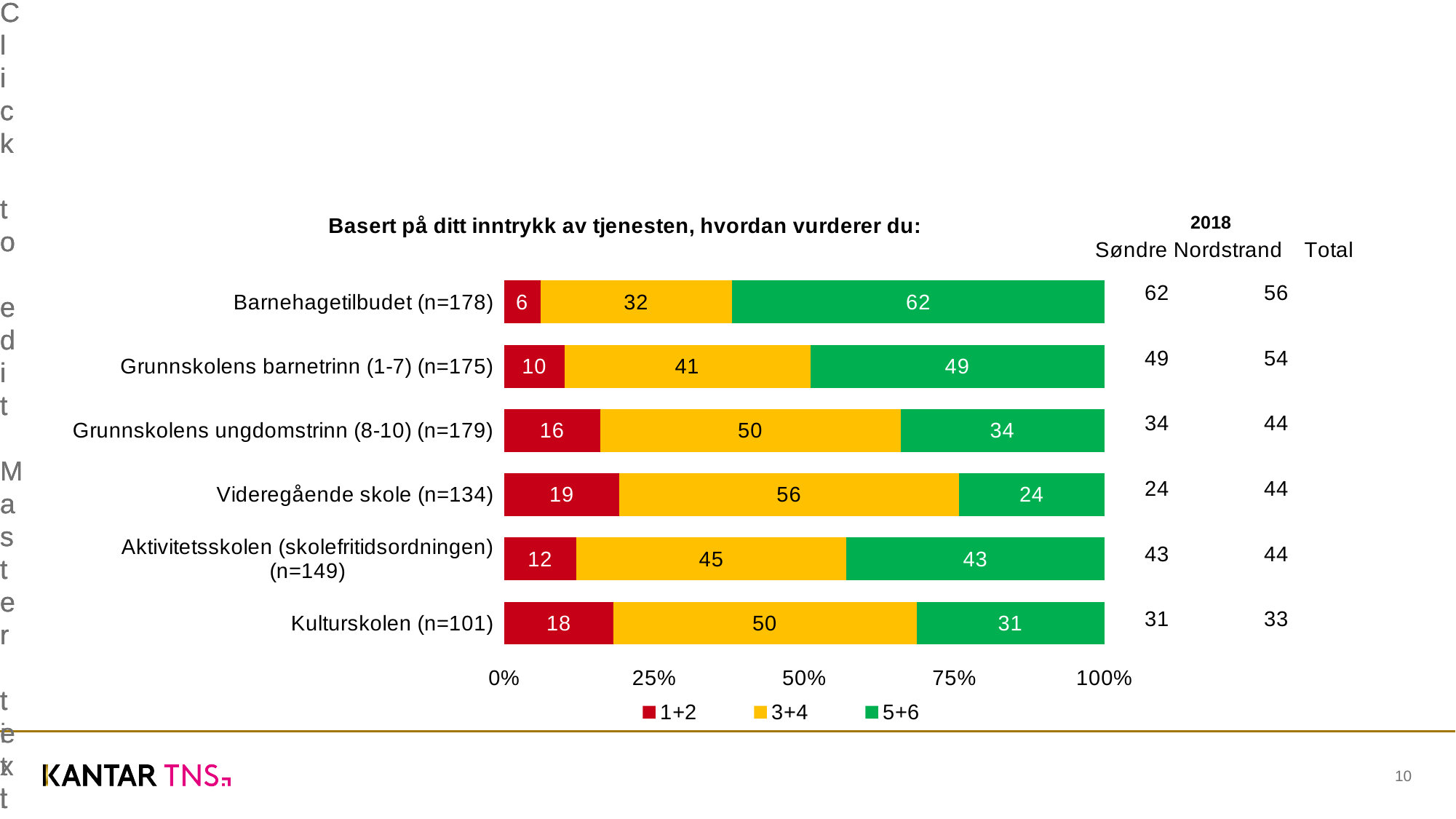
Which is larger: the 3+4 value for Videregående skole (n=134) or the 3+4 value for Kulturskolen (n=101)? Videregående skole (n=134) How many series does the legend list? 3 Which category has the lowest 1+2 value? Barnehagetilbudet (n=178) What is the value of the 5+6 segment for Barnehagetilbudet (n=178)? 62 Which colour represents the 1+2 series in the legend? Red What is the value of the 3+4 segment for Aktivitetsskolen (skolefritidsordningen) (n=149)? 45 What is the total of the stacked bar for Kulturskolen (n=101)? 99 What kind of chart is shown on the slide? Stacked bar chart How many categories are plotted in the chart? 6 What is the value of the 1+2 segment for Videregående skole (n=134)? 19 What is the difference between the 5+6 values for Grunnskolens barnetrinn (1-7) (n=175) and Grunnskolens ungdomstrinn (8-10) (n=179)? 15 Which category has the highest 5+6 value? Barnehagetilbudet (n=178)